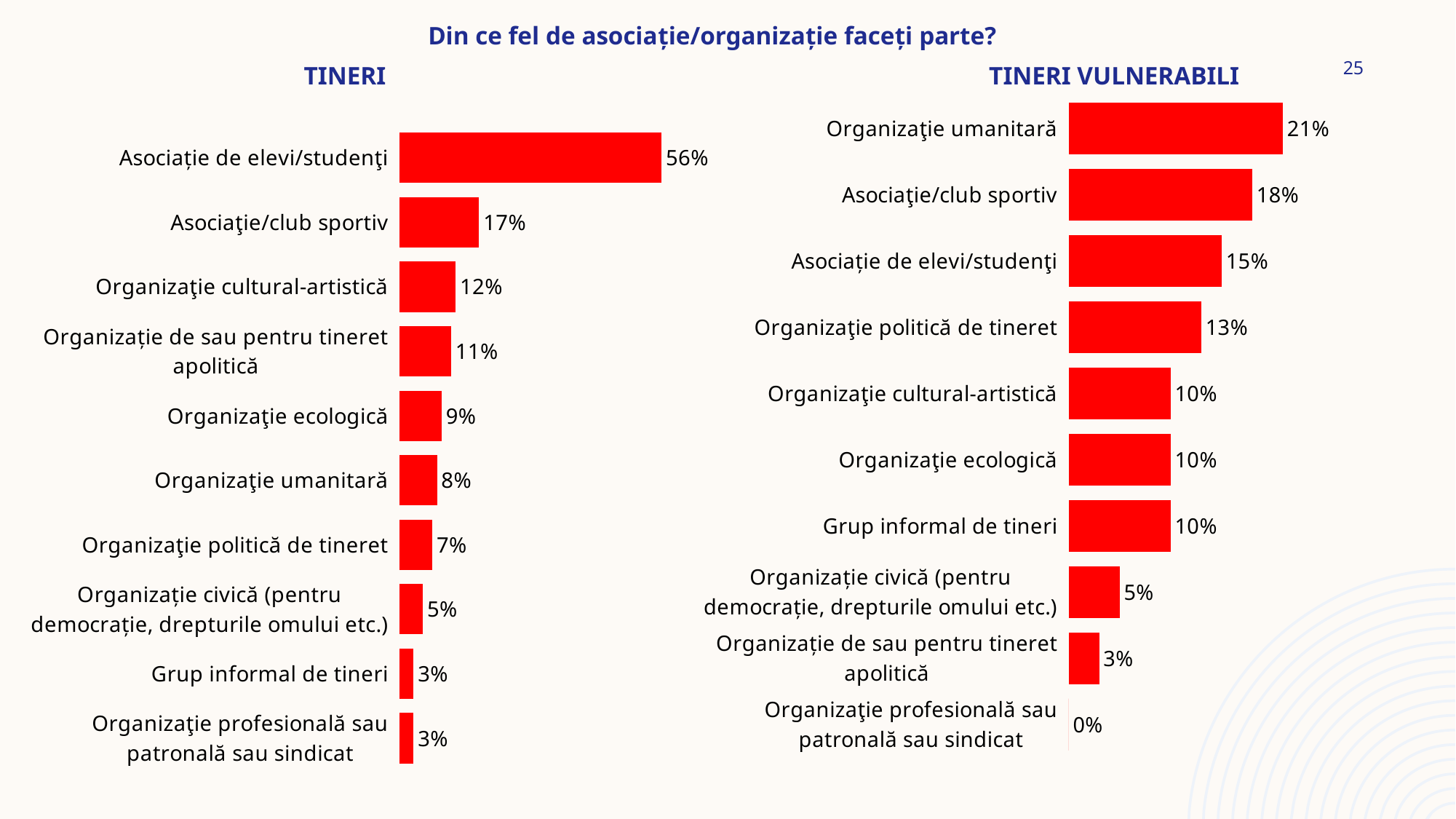
In the TINERI VULNERABILI chart, what is the value for Organizaţie umanitară? 21% In the TINERI VULNERABILI chart, what is the difference between Organizaţie umanitară and Asociaţie/club sportiv? 3% In the TINERI VULNERABILI chart, which is larger: Organizaţie politică de tineret or Organizație civică (pentru democrație, drepturile omului etc.)? Organizaţie politică de tineret In the TINERI chart, what is the value for Asociație de elevi/studenţi? 56% In the TINERI chart, which category has the highest value? Asociație de elevi/studenţi In the TINERI chart, what is the difference between Asociaţie/club sportiv and Organizaţie cultural-artistică? 5% In the TINERI VULNERABILI chart, which category has the lowest value? Organizaţie profesională sau patronală sau sindicat In the TINERI chart, how many categories are shown? 10 In the TINERI VULNERABILI chart, how many categories are shown? 10 What is the title shown above both charts? Din ce fel de asociație/organizație faceți parte? In the TINERI chart, what is the value for Grup informal de tineri? 3% What kind of chart is the TINERI chart? Bar chart